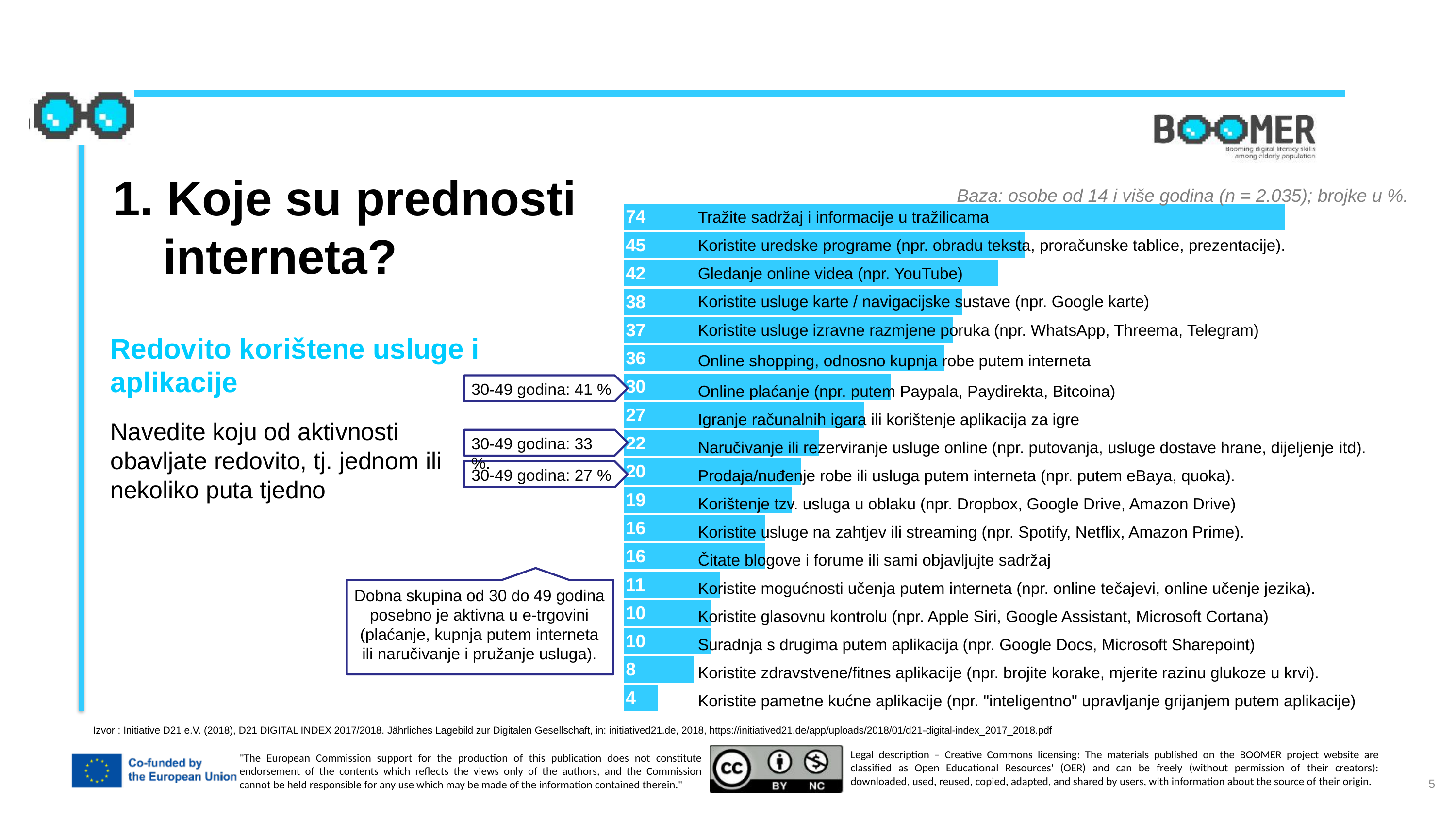
According to the callout, what is the value for the 30-49 age group for "Online plaćanje"? 41 % What is the difference between the value for "Online plaćanje" and the value for "Igranje računalnih igara"? 3 What value is shown for "Gledanje online videa (npr. YouTube)"? 42 What kind of chart is shown on the slide? Bar chart How many activities (bars) are shown in the chart? 18 Which has a larger value: "Koristite zdravstvene/fitnes aplikacije" or "Koristite mogućnosti učenja putem interneta"? Koristite mogućnosti učenja putem interneta What value is shown for "Online shopping, odnosno kupnja robe putem interneta"? 36 Which activity has the lowest value in the chart? Koristite pametne kućne aplikacije Which activity has the highest value in the chart? Tražite sadržaj i informacije u tražilicama What is the difference between the value for "Tražite sadržaj i informacije u tražilicama" and the value for "Koristite uredske programe"? 29 Which has a larger value: "Koristite usluge karte / navigacijske sustave" or "Korištenje tzv. usluga u oblaku"? Koristite usluge karte / navigacijske sustave What value is shown for "Koristite glasovnu kontrolu (npr. Apple Siri, Google Assistant, Microsoft Cortana)"? 10